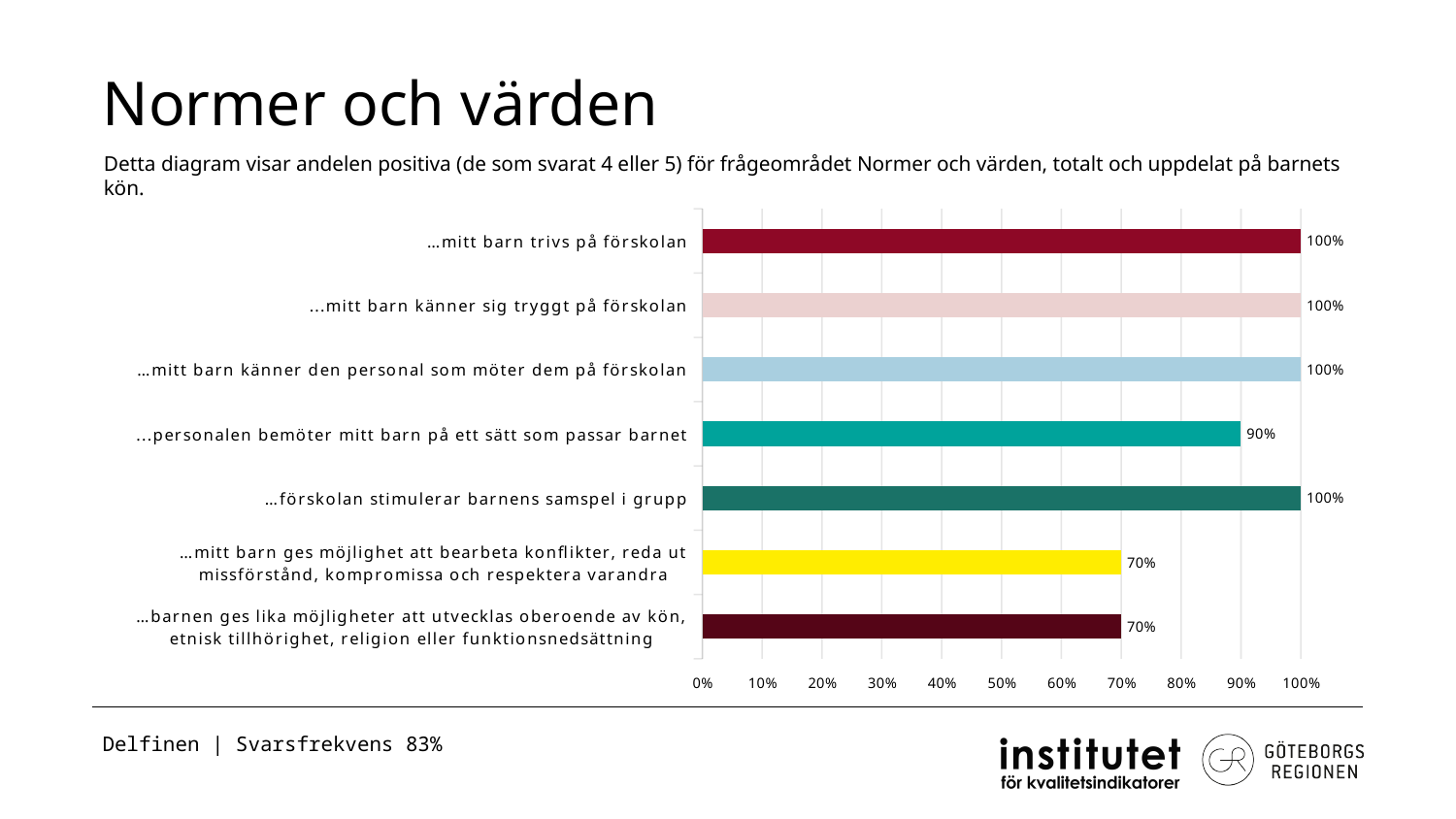
What is the value for "…förskolan stimulerar barnens samspel i grupp"? 100% What is the lowest value shown in the chart? 70% What is the value for "...personalen bemöter mitt barn på ett sätt som passar barnet"? 90% What is the value for "…mitt barn ges möjlighet att bearbeta konflikter, reda ut missförstånd, kompromissa och respektera varandra"? 70% Which has the larger value: "...personalen bemöter mitt barn på ett sätt som passar barnet" or "…mitt barn ges möjlighet att bearbeta konflikter, reda ut missförstånd, kompromissa och respektera varandra"? ...personalen bemöter mitt barn på ett sätt som passar barnet How many categories (bars) does the chart show? 7 What is the difference between the value for "...personalen bemöter mitt barn på ett sätt som passar barnet" and the value for "…barnen ges lika möjligheter att utvecklas oberoende av kön, etnisk tillhörighet, religion eller funktionsnedsättning"? 20% What is the value for "…mitt barn trivs på förskolan"? 100% Is the value for "…barnen ges lika möjligheter att utvecklas oberoende av kön, etnisk tillhörighet, religion eller funktionsnedsättning" greater or less than 80%? less What is the difference between the value for "…mitt barn trivs på förskolan" and the value for "...personalen bemöter mitt barn på ett sätt som passar barnet"? 10% What kind of chart is shown on the slide? bar chart What is the title of the slide containing the chart? Normer och värden